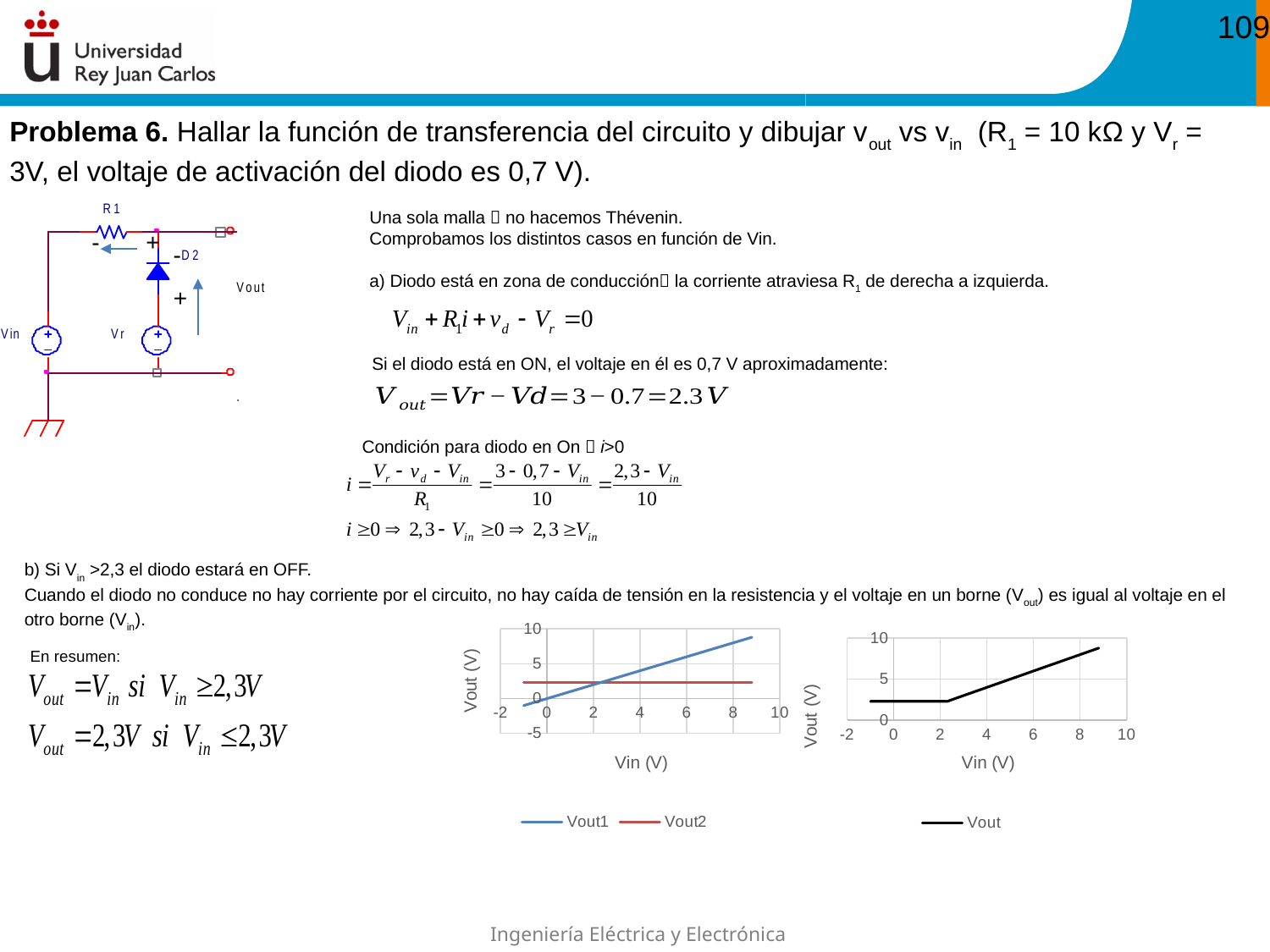
In the left chart, is the value of Vout2 at Vin = 8 greater or less than 5? less In the right chart, is the value of Vout at Vin = 0 greater or less than 5? less What is the x-axis title of the right chart? Vin (V) In the left chart, at Vin = 8, which series has the larger value, Vout1 or Vout2? Vout1 In the left chart, does Vout2 rise, fall or stay flat as Vin increases? stay flat What type of chart is the right chart (with Vout)? line chart In the left chart, what are the names of the two series in the legend? Vout1 and Vout2 In the left chart, is the value of Vout1 at Vin = 8 greater or less than 5? greater What type of chart is the left chart (with Vout1 and Vout2)? line chart How many series does the legend of the left chart list? 2 In the left chart, does Vout1 rise or fall as Vin increases? rise How many series does the legend of the right chart list? 1